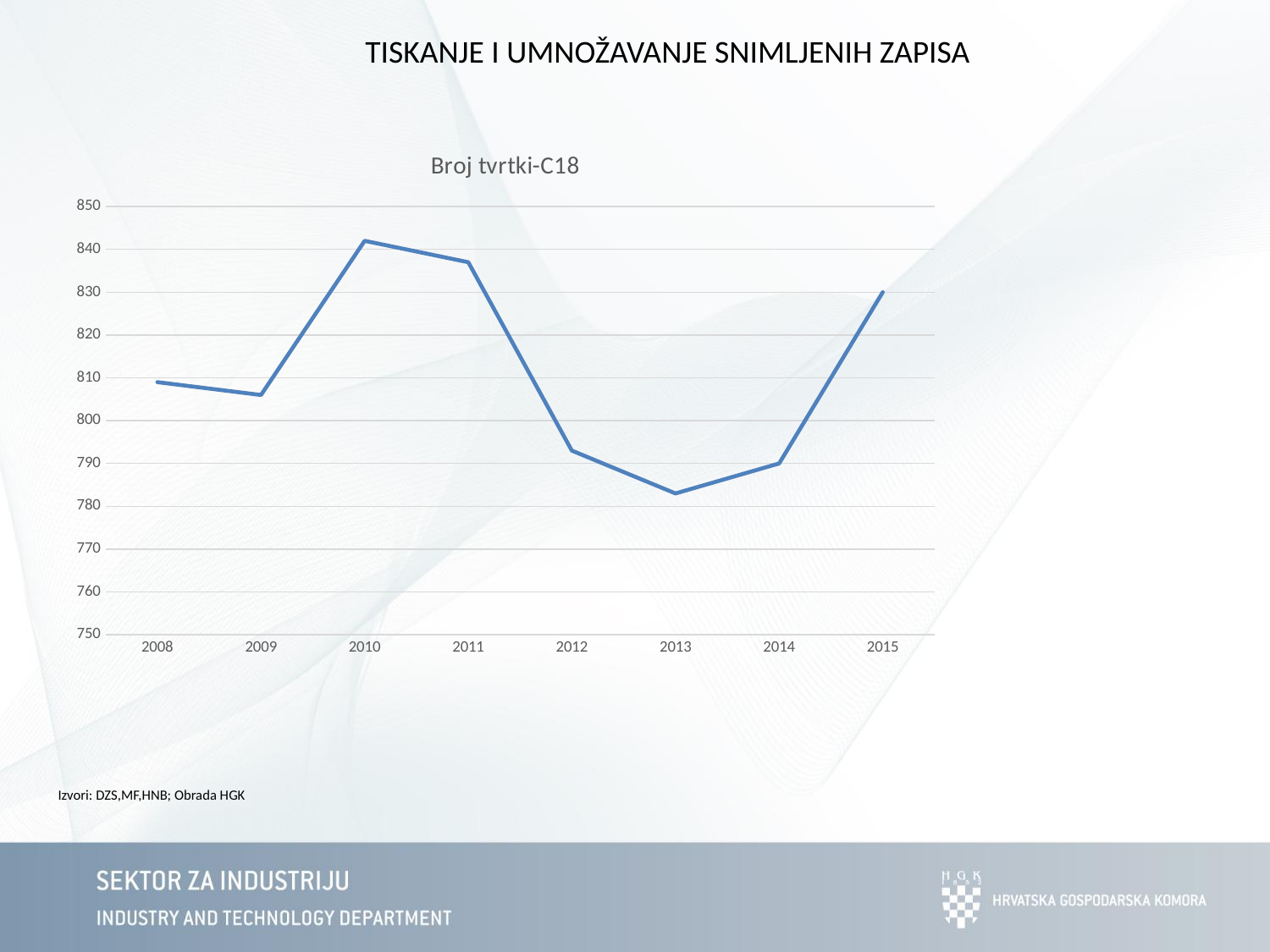
Do the values rise or fall from 2010 to 2013? fall What kind of chart is shown on the slide? line chart Is the value for 2013 greater or less than 790? less What is the title of the chart? Broj tvrtki-C18 How many years are plotted on the x axis of the chart? 8 Is the value for 2012 greater or less than 800? less Do the values rise or fall from 2013 to 2015? rise Is the value for 2015 greater or less than 820? greater Which year has the larger value, 2012 or 2015? 2015 In which year is the value lowest? 2013 In which year is the value highest? 2010